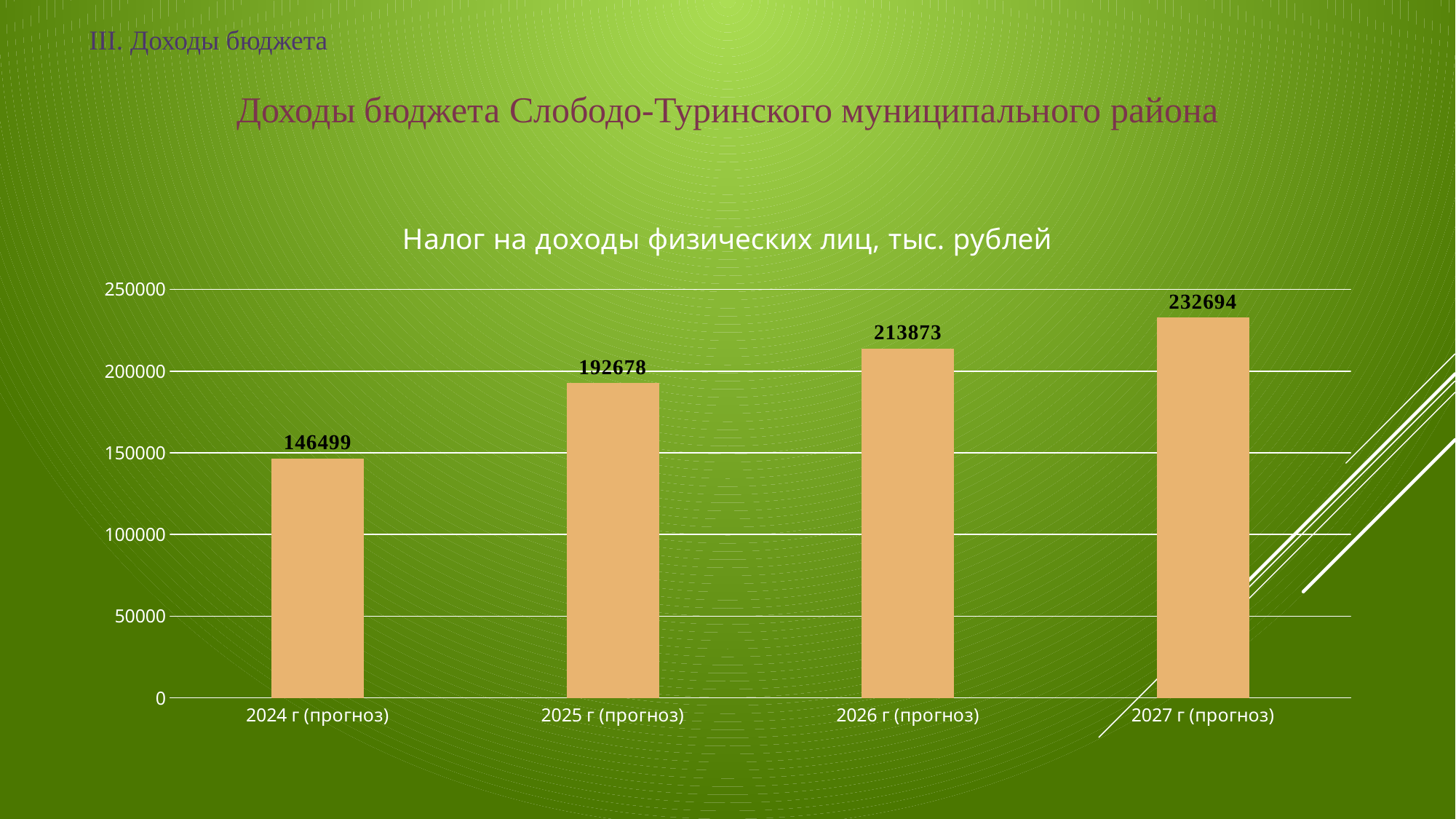
Which year has the lowest value? 2024 г (прогноз) What is the value for 2024 г (прогноз)? 146499 What kind of chart is shown? bar chart What is the value for 2027 г (прогноз)? 232694 What is the difference between the values for 2026 г (прогноз) and 2025 г (прогноз)? 21195 Which is larger, the value for 2025 г (прогноз) or 2026 г (прогноз)? 2026 г (прогноз) Which year has the highest value? 2027 г (прогноз) What is the difference between the values for 2027 г (прогноз) and 2024 г (прогноз)? 86195 What is the value for 2026 г (прогноз)? 213873 Is the value for 2025 г (прогноз) greater or less than 200000? less How many categories are shown on the x axis? 4 What is the value for 2025 г (прогноз)? 192678